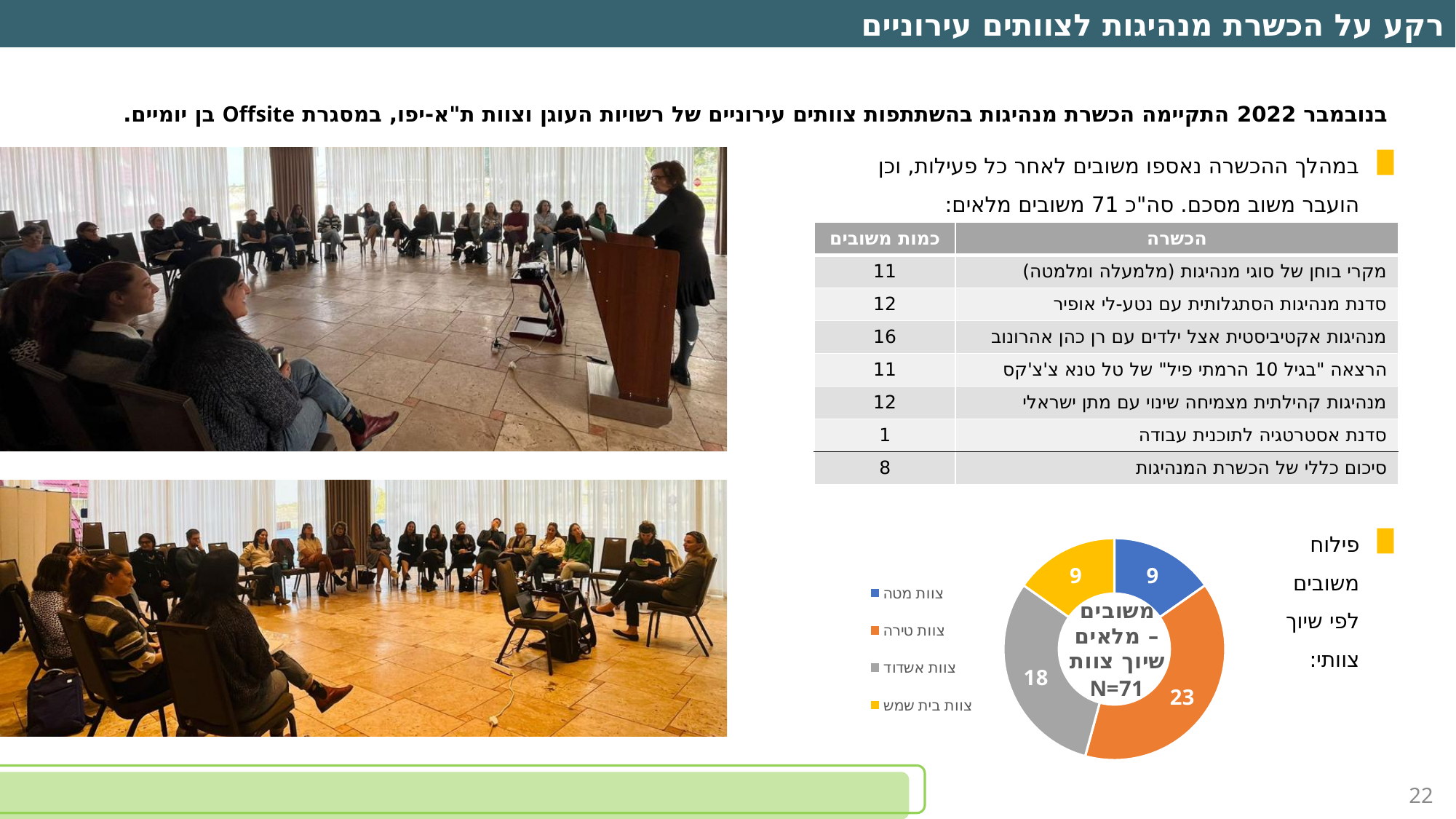
What is the difference between the values for צוות טירה and צוות אשדוד in the doughnut chart? 5 Which team has the largest slice in the doughnut chart? צוות טירה What value does the doughnut chart show for צוות בית שמש? 9 What is the difference between the values for צוות אשדוד and צוות מטה in the doughnut chart? 9 What value does the doughnut chart show for צוות מטה? 9 How many teams (slices) does the doughnut chart show? 4 Which is larger in the doughnut chart, the value for צוות אשדוד or the value for צוות בית שמש? צוות אשדוד How many full feedback forms (משובים) are attributed to צוות טירה in the doughnut chart? 23 What colour is the slice for צוות טירה in the doughnut chart? Orange What value does the doughnut chart show for צוות אשדוד? 18 What kind of chart is shown on the slide? Doughnut (pie) chart Which teams share the smallest value in the doughnut chart? צוות מטה and צוות בית שמש